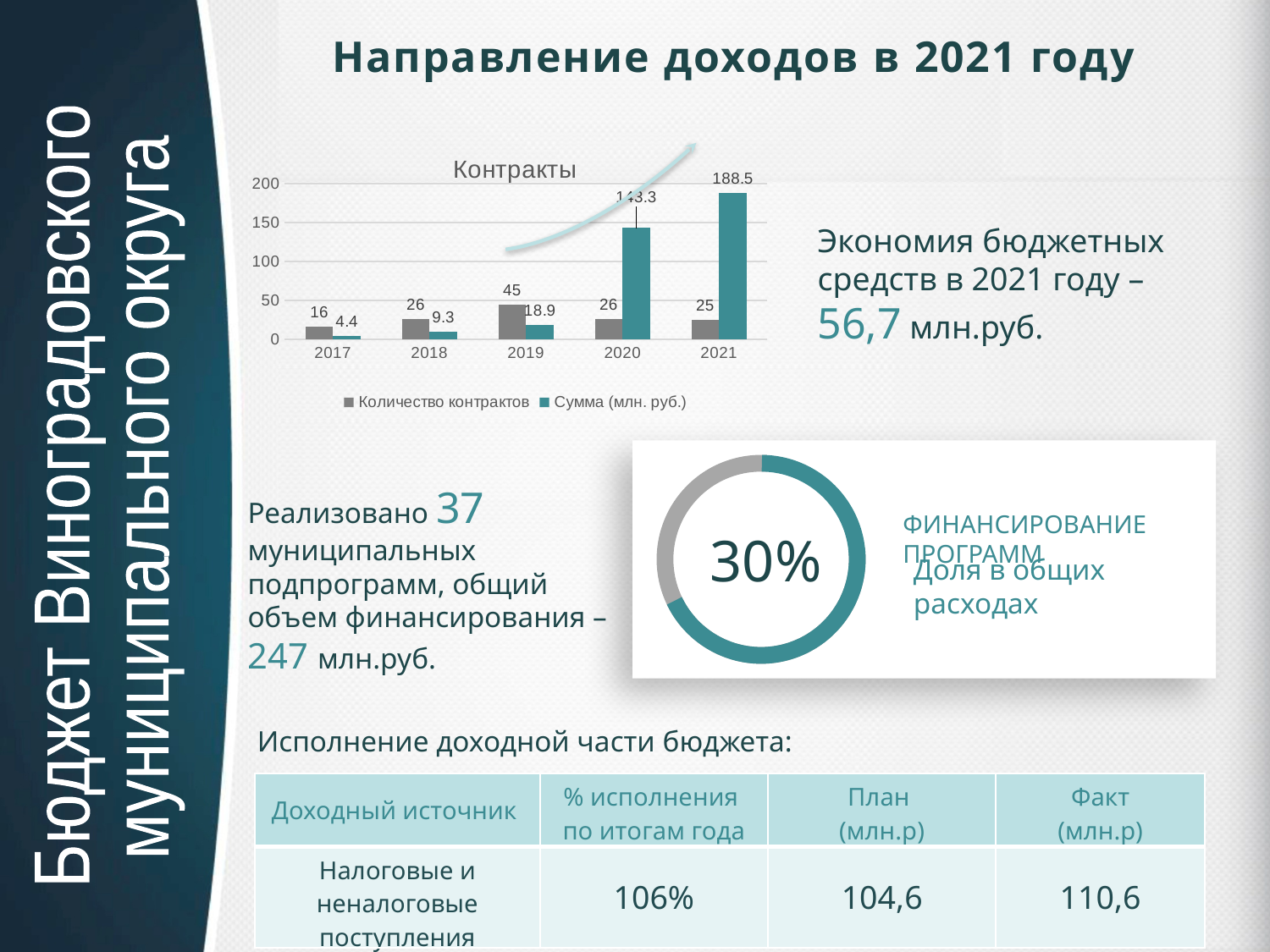
In the Контракты chart, which year has the highest Количество контрактов? 2019 In the Контракты chart, what is the value of Количество контрактов for 2019? 45 In the Контракты chart, what is the value of Сумма (млн. руб.) for 2017? 4.4 What is the title of the bar chart? Контракты In the Контракты chart, is the value of Сумма (млн. руб.) for 2020 greater or less than 100? greater In the Контракты chart, is Сумма (млн. руб.) larger in 2021 or in 2019? 2021 What percentage is shown in the centre of the donut chart? 30% In the Контракты chart, which year has the lowest Сумма (млн. руб.)? 2017 How many years are shown on the x axis of the Контракты chart? 5 In the Контракты chart, what is the value of Сумма (млн. руб.) for 2021? 188.5 In the Контракты chart, what is the difference between Количество контрактов in 2019 and 2018? 19 How many series does the legend of the Контракты chart list? 2